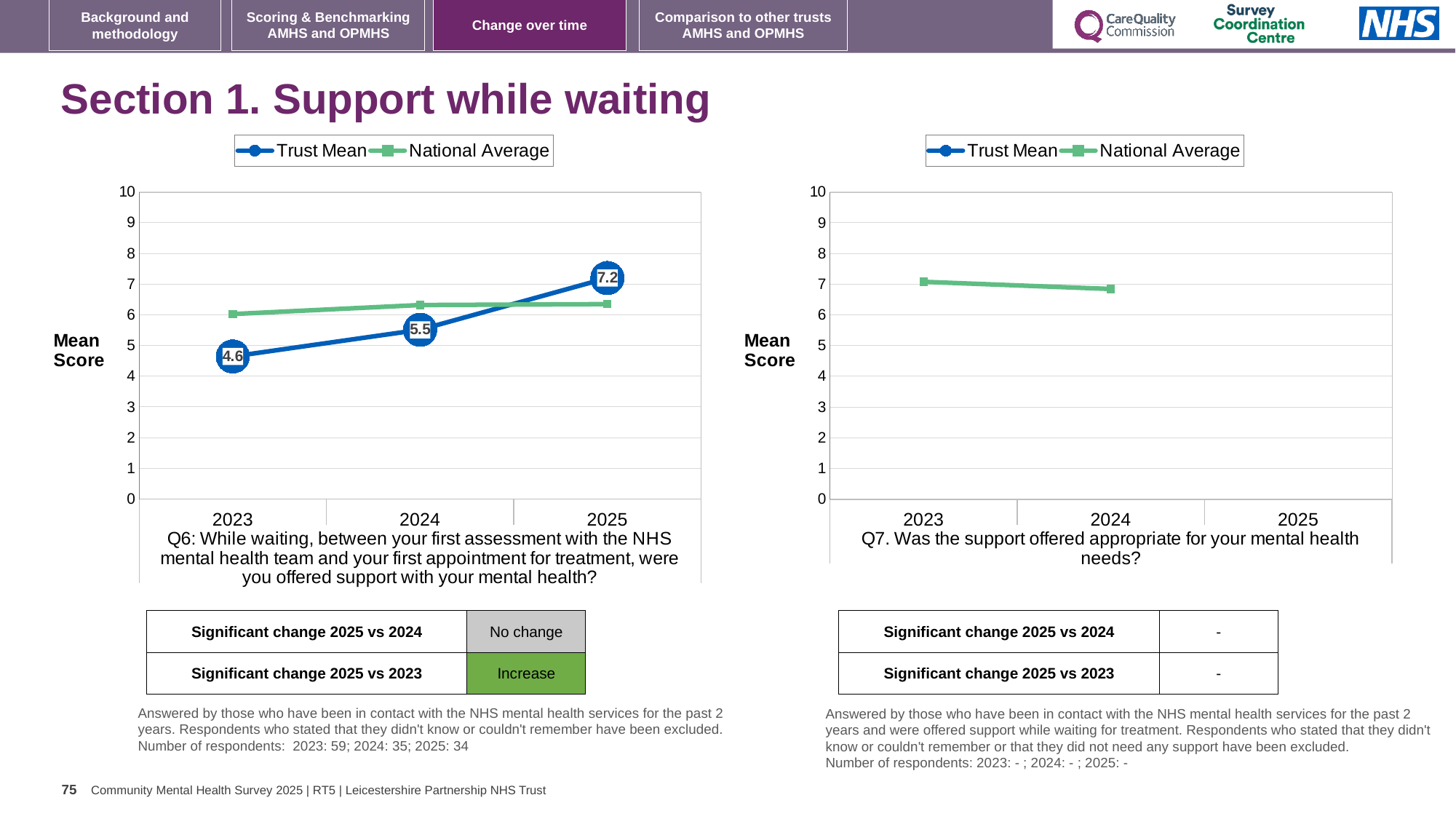
In the Q6 chart on the left, what is the difference between the Trust Mean scores for 2025 and 2023? 2.6 In the Q6 chart on the left, what is the Trust Mean score for 2025? 7.2 In the Q6 chart on the left, does the Trust Mean rise or fall from 2023 to 2025? rise In the Q6 chart on the left, what is the Trust Mean score for 2023? 4.6 In the Q6 chart on the left, which is larger in 2023: the Trust Mean or the National Average? National Average In the Q6 chart on the left, which year has the highest Trust Mean score? 2025 In the Q7 chart on the right, is the National Average for 2023 greater or less than 6? greater What kind of chart is the Q7 chart on the right? line chart In the Q6 chart on the left, what is the Trust Mean score for 2024? 5.5 In the Q6 chart on the left, is the National Average for 2023 greater or less than 5? greater How many series does the legend of the Q6 chart on the left list? 2 In the Q6 chart on the left, which year has the lowest Trust Mean score? 2023